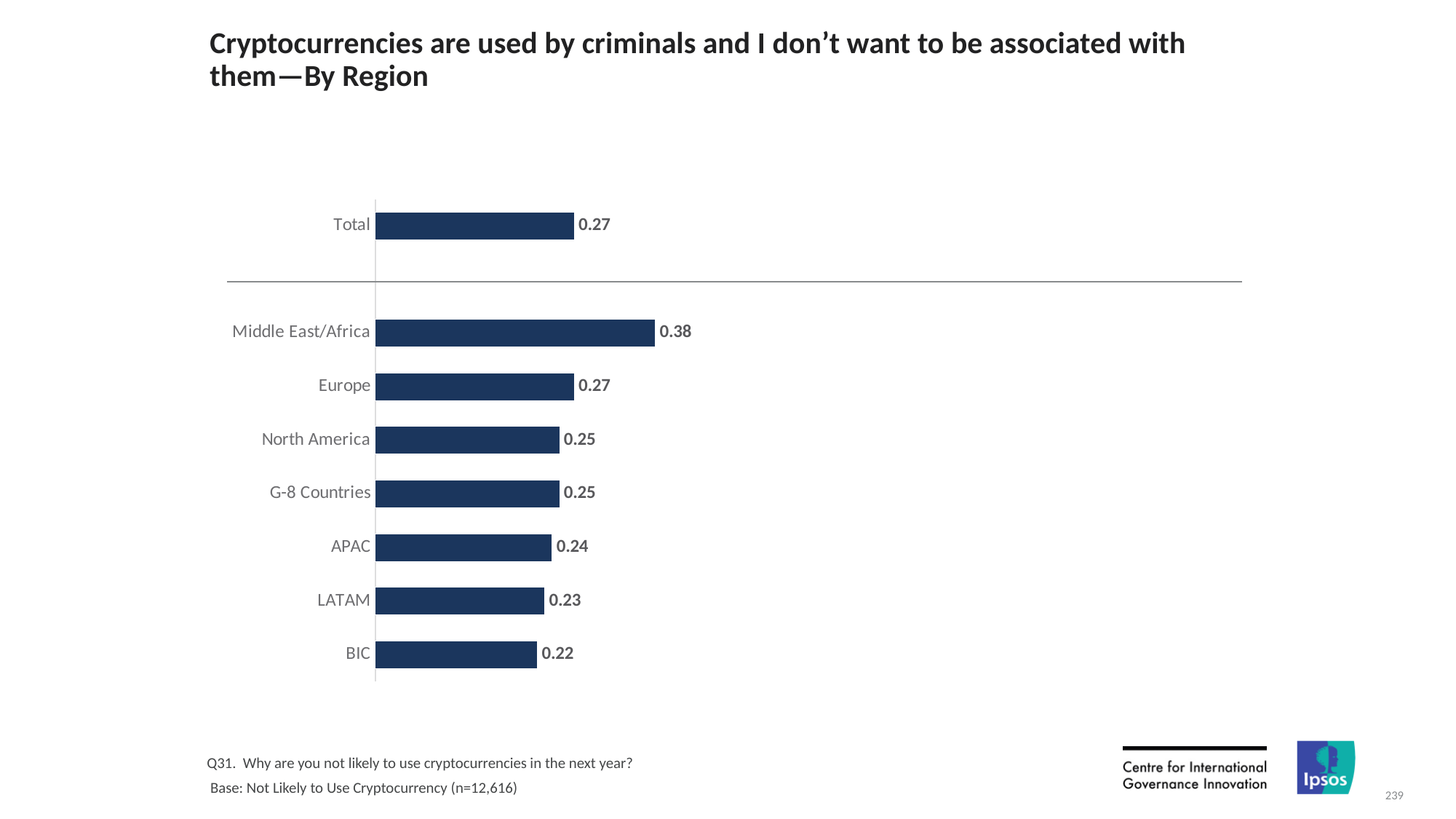
Which region has the lowest value? BIC What is the value for LATAM? 0.23 What is the difference between the values for Europe and North America? 0.02 How many bars are shown in the chart, including Total? 8 Which region has the highest value? Middle East/Africa What is the value for Total? 0.27 What is the survey question referenced at the bottom of the slide? Q31. Why are you not likely to use cryptocurrencies in the next year? What is the value for Middle East/Africa? 0.38 What is the value for APAC? 0.24 What is the difference between the values for Middle East/Africa and BIC? 0.16 Which is larger, the value for Middle East/Africa or the value for Europe? Middle East/Africa What kind of chart is shown on the slide? Bar chart